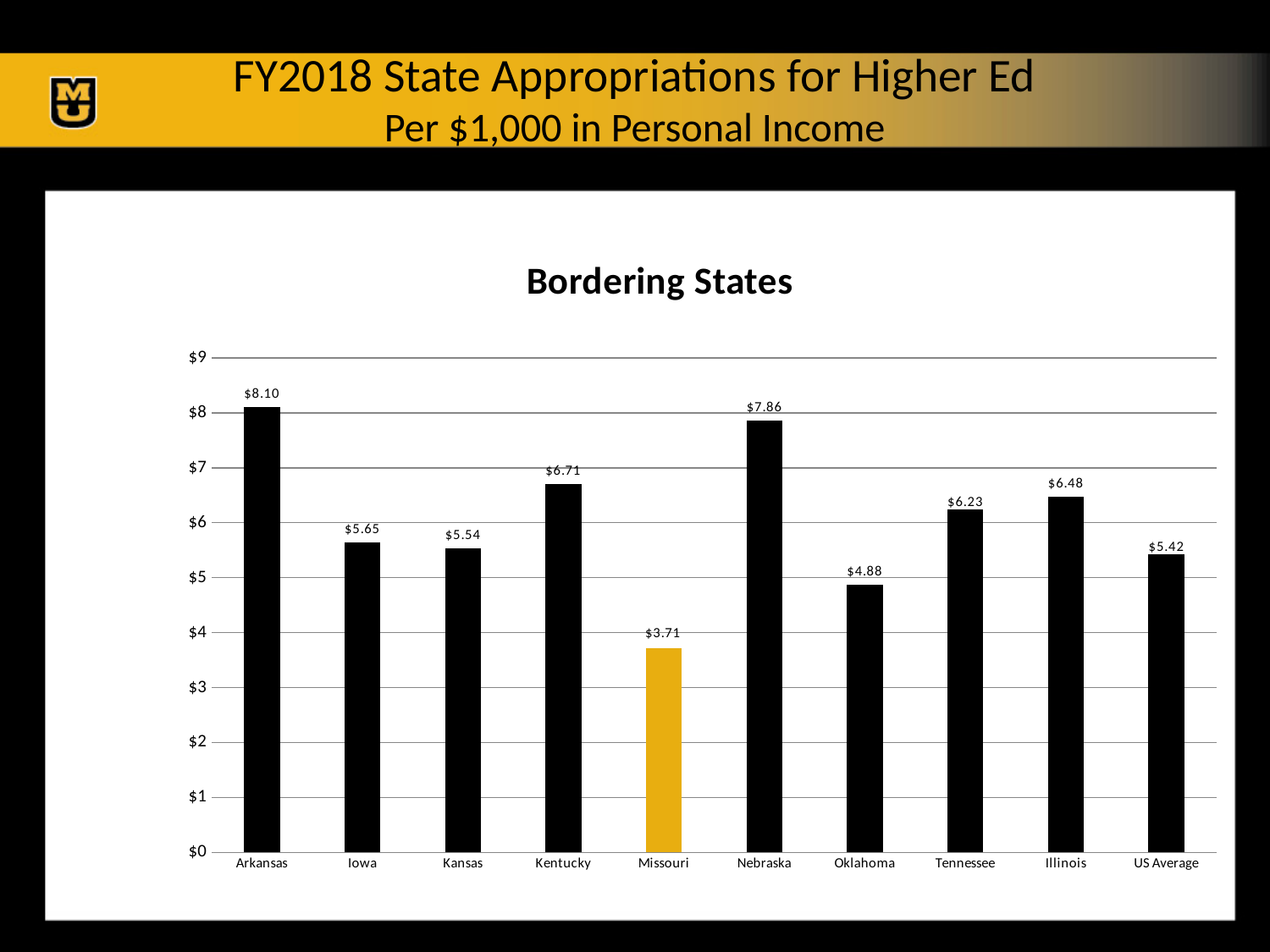
What is the value for US Average? $5.42 Which bar is coloured gold instead of black? Missouri What is the title of the chart? Bordering States Which state has the highest value? Arkansas What is the difference between the values for Arkansas and Missouri? $4.39 Is the value for Oklahoma greater or less than $5? less What is the value for Missouri? $3.71 What kind of chart is this? bar chart How many categories are shown on the x axis? 10 What is the value for Nebraska? $7.86 Which category has the lowest value? Missouri Which is larger, the value for Kentucky or the value for Illinois? Kentucky